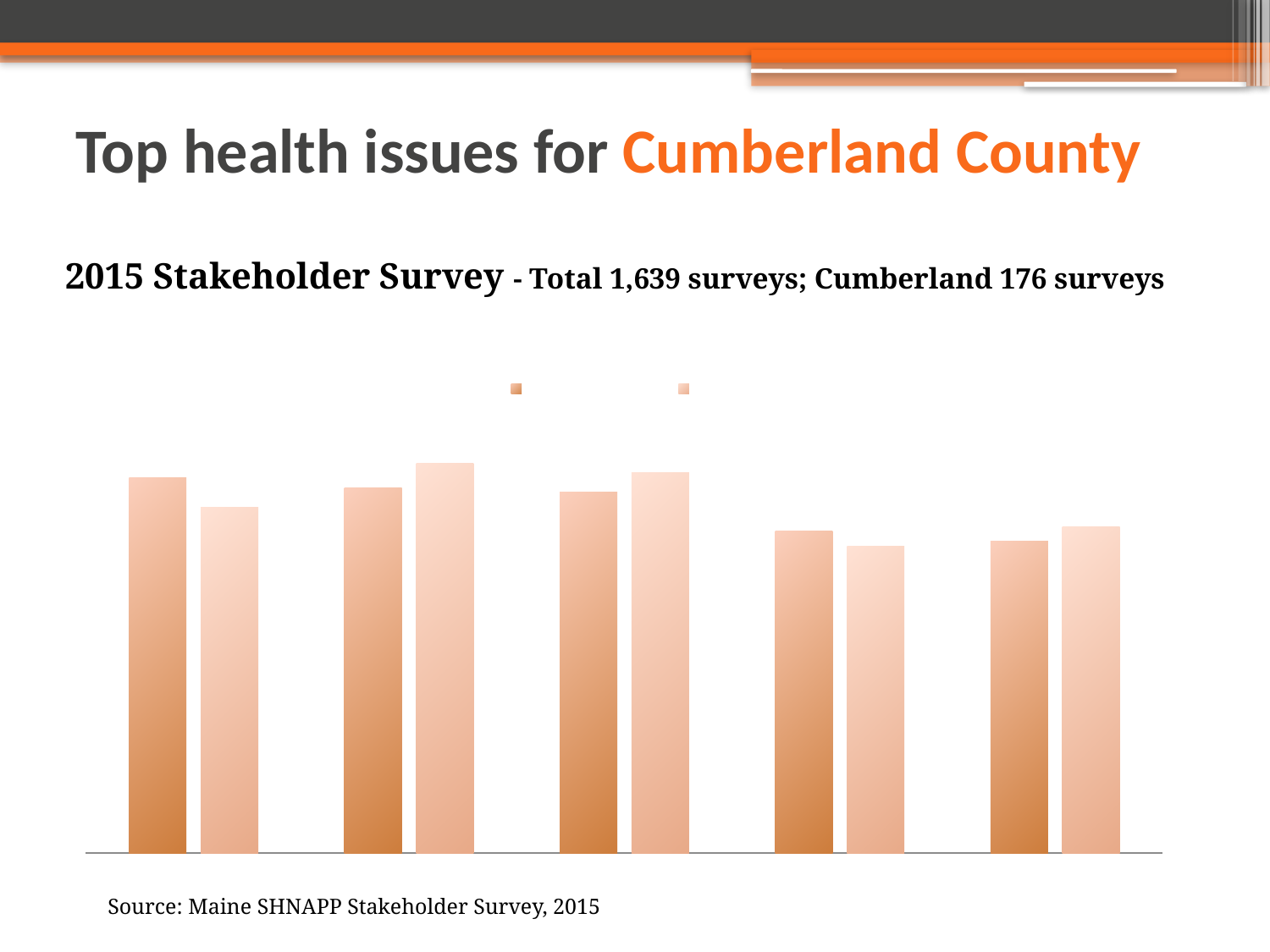
How many bars in total are plotted in the chart? 10 How many series does the chart's legend list? 2 How many groups of bars (categories) are plotted in the chart? 5 Do the values of the darker orange bars generally rise or fall from left to right along the x axis? fall What kind of chart is shown on the slide? bar chart